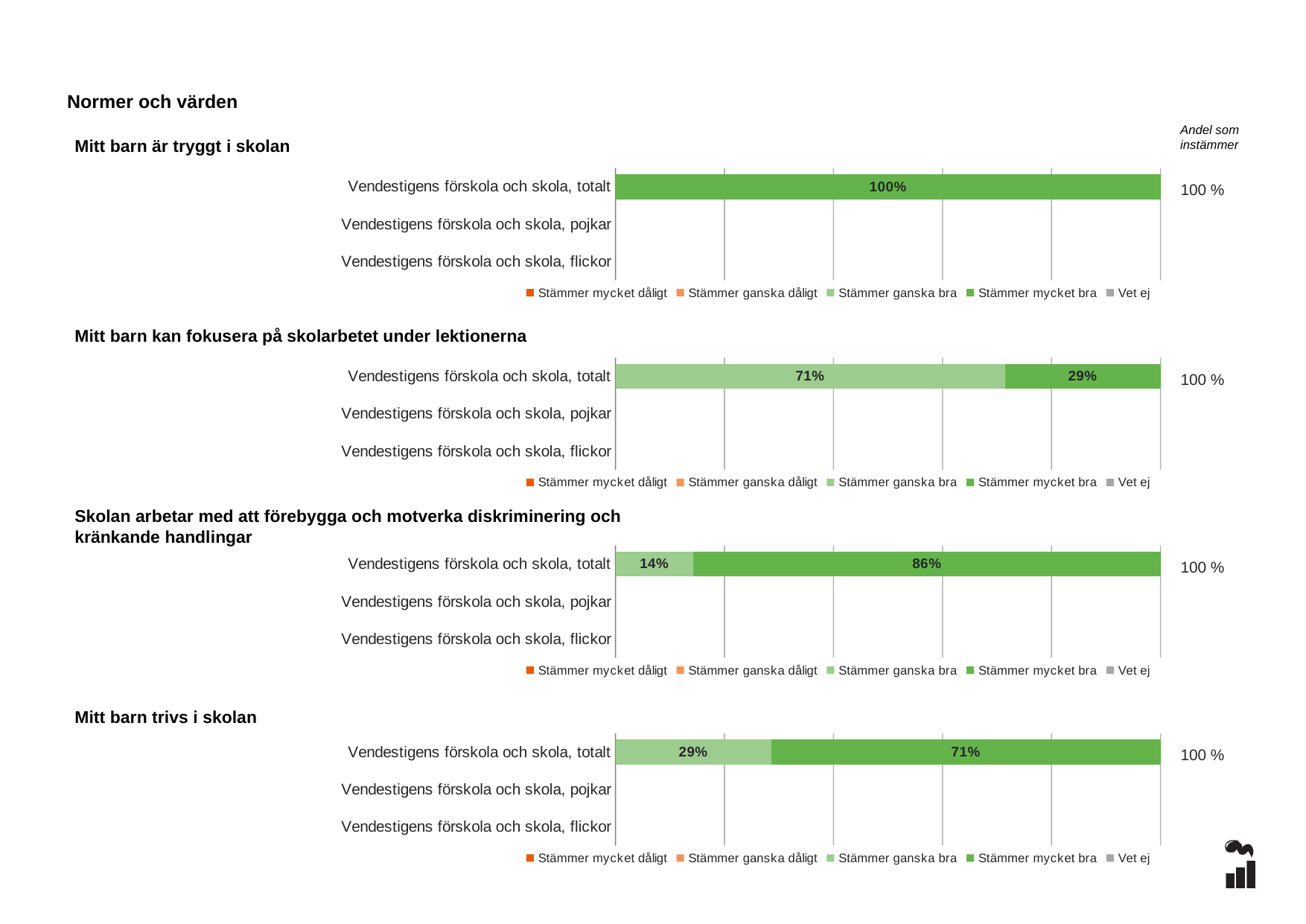
What kind of chart is 'Mitt barn trivs i skolan'? Stacked bar chart In the chart 'Skolan arbetar med att förebygga och motverka diskriminering och kränkande handlingar', what is the difference between the 'Stämmer mycket bra' and 'Stämmer ganska bra' values for Vendestigens förskola och skola, totalt? 72% In the chart 'Mitt barn kan fokusera på skolarbetet under lektionerna', what is the total of the stacked bar for Vendestigens förskola och skola, totalt? 100% In the chart 'Skolan arbetar med att förebygga och motverka diskriminering och kränkande handlingar', what is the value for 'Stämmer mycket bra' for Vendestigens förskola och skola, totalt? 86% In the chart 'Mitt barn trivs i skolan', which is larger for Vendestigens förskola och skola, totalt: 'Stämmer ganska bra' or 'Stämmer mycket bra'? Stämmer mycket bra What is the title of the topmost chart on the slide? Mitt barn är tryggt i skolan How many categories are shown on the y axis of the chart 'Mitt barn trivs i skolan'? 3 In the chart 'Mitt barn kan fokusera på skolarbetet under lektionerna', what is the value for 'Stämmer ganska bra' for Vendestigens förskola och skola, totalt? 71% How many series does the legend of the chart 'Mitt barn är tryggt i skolan' list? 5 In the chart 'Mitt barn kan fokusera på skolarbetet under lektionerna', what is the value for 'Stämmer mycket bra' for Vendestigens förskola och skola, totalt? 29% In the chart 'Mitt barn trivs i skolan', what is the value for 'Stämmer ganska bra' for Vendestigens förskola och skola, totalt? 29% In the chart 'Mitt barn är tryggt i skolan', what is the value for 'Stämmer mycket bra' for Vendestigens förskola och skola, totalt? 100%